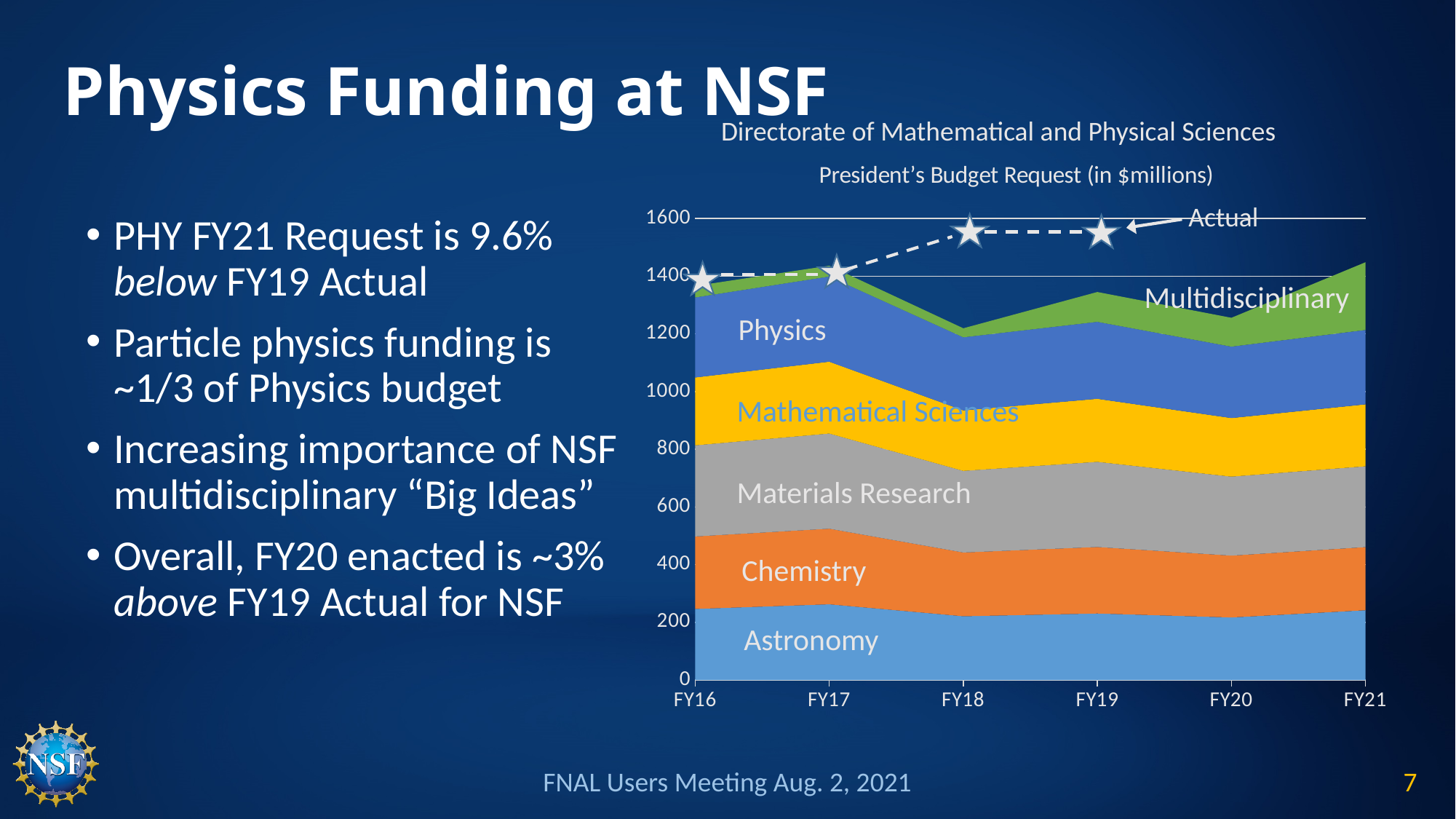
Which fiscal year has the larger total budget request, FY20 or FY21? FY21 Which is larger at FY18: the Actual value or the total budget request? Actual How many fiscal years are shown along the x axis of the chart? 6 Does the Actual line rise or fall from FY16 to FY18? rise Which funding area forms the bottom layer of the stacked area chart? Astronomy How many funding areas are labeled within the stacked areas of the chart? 6 Is the Astronomy value for FY16 greater or less than 200? greater What does the dashed line with star markers on the chart represent? Actual Is the total budget request for FY21 greater or less than 1400? greater What kind of chart is shown on the slide? stacked area chart Is the total budget request for FY16 greater or less than 1400? less